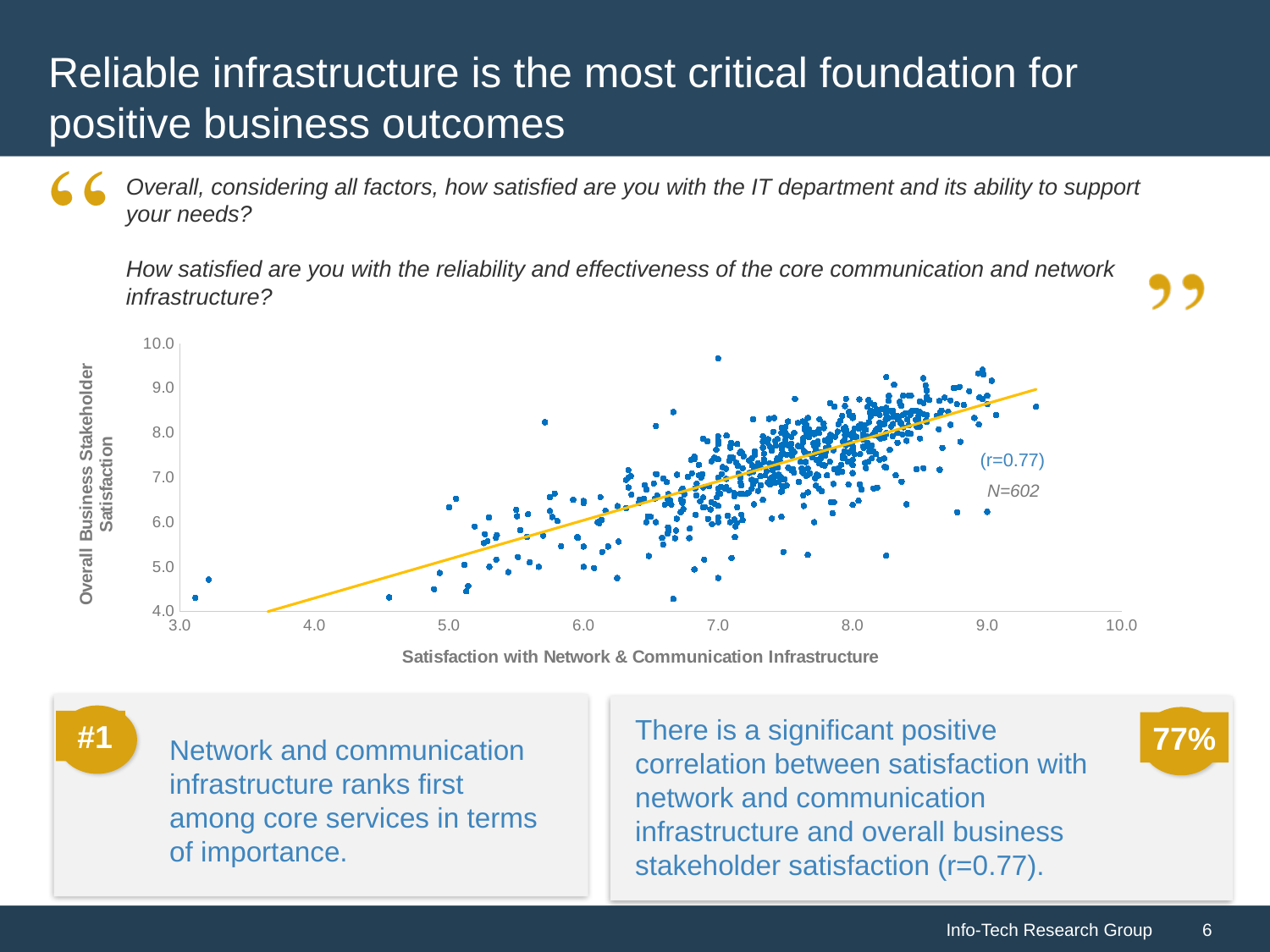
What is the label of the y axis? Overall Business Stakeholder Satisfaction How many data points does the chart report (N)? 602 As satisfaction with network and communication infrastructure increases along the x axis, do the overall business stakeholder satisfaction values generally rise or fall? Rise What sample size (N) is printed on the chart? N=602 What is the highest value shown on the y axis? 10.0 What correlation coefficient (r) is printed on the chart? r=0.77 What is the label of the x axis? Satisfaction with Network & Communication Infrastructure Is the sample size N shown on the chart greater or less than 500? greater What is the lowest value shown on the x axis? 3.0 What kind of chart is shown on the slide? Scatter chart What is the lowest value shown on the y axis? 4.0 Is the correlation coefficient shown on the chart greater or less than 0.5? greater